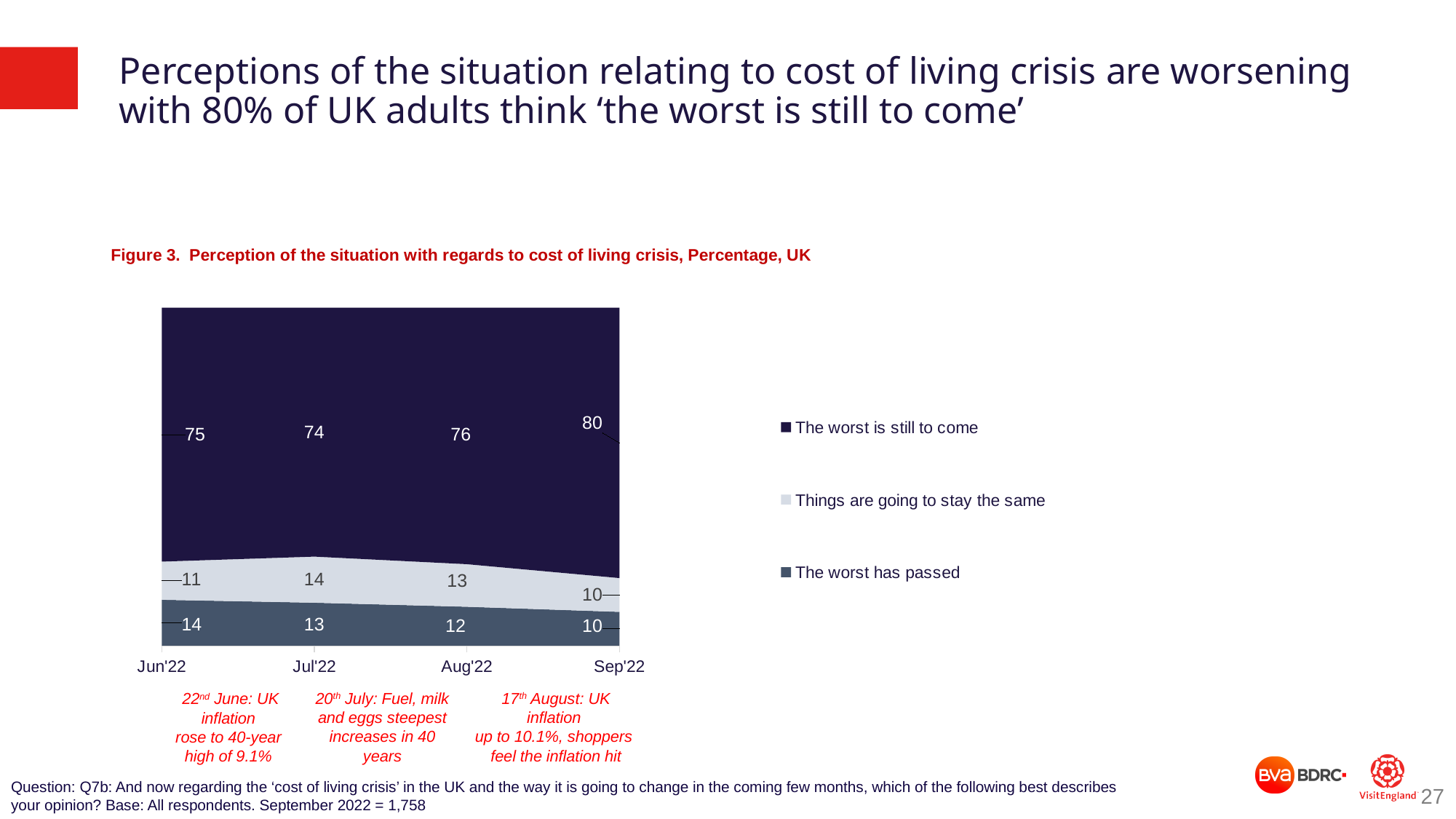
In which month is the value for 'The worst is still to come' highest? Sep'22 In which month is the value for 'The worst has passed' lowest? Sep'22 What is the value for 'The worst has passed' in Jun'22? 14 How many time points are shown on the x axis? 4 What percentage of UK adults said 'The worst is still to come' in Sep'22? 80 By how much did 'The worst is still to come' increase from Aug'22 to Sep'22? 4 Does the value for 'The worst has passed' rise or fall from Jun'22 to Sep'22? Fall What kind of chart is shown in Figure 3? Stacked area chart What is the title of Figure 3? Perception of the situation with regards to cost of living crisis, Percentage, UK What is the value for 'Things are going to stay the same' in Jul'22? 14 Which is larger in Jun'22: 'Things are going to stay the same' or 'The worst has passed'? The worst has passed How many series does the legend list? 3